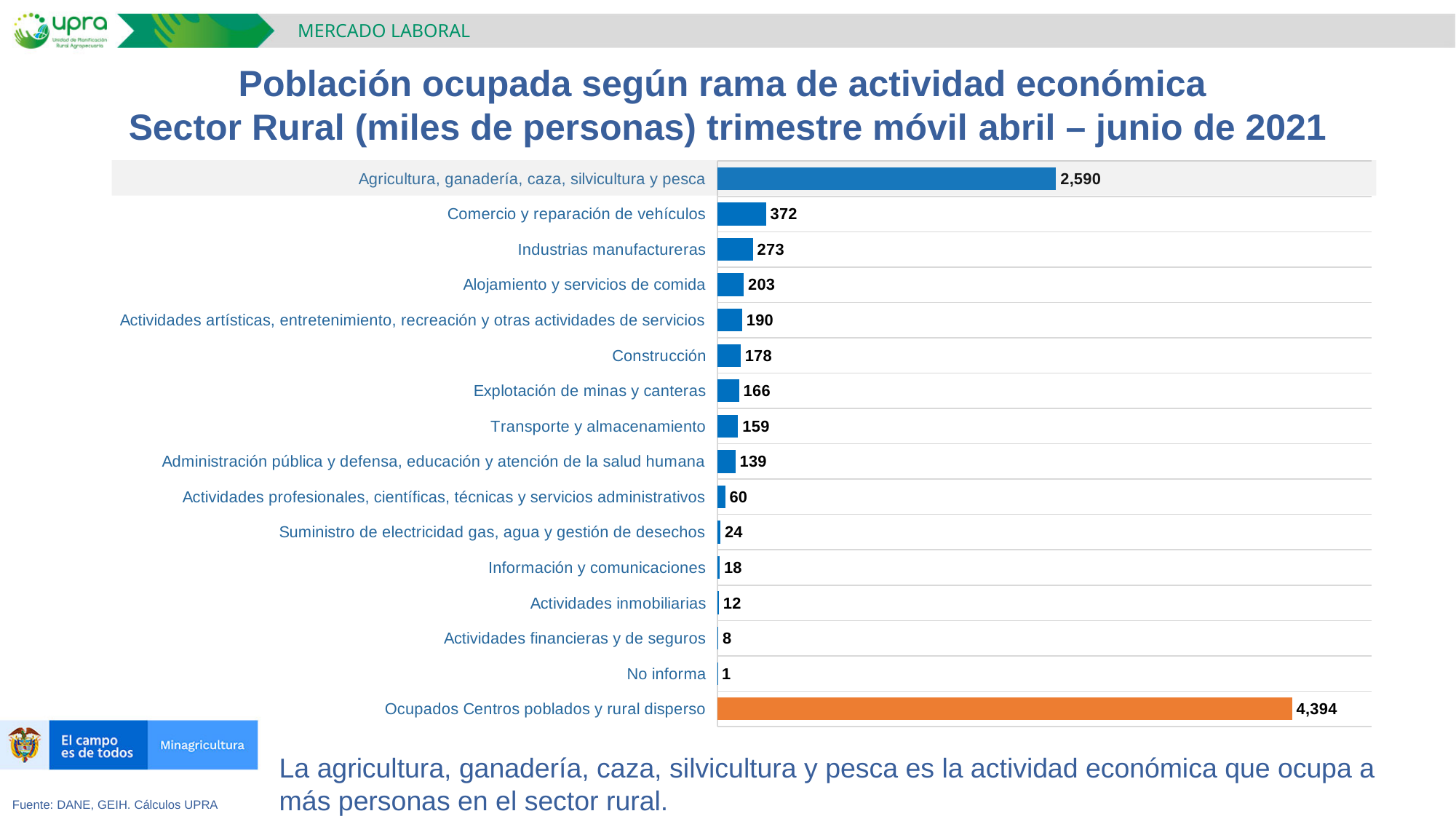
What is the difference between the values for Agricultura, ganadería, caza, silvicultura y pesca and Comercio y reparación de vehículos? 2,218 How many categories (bars) are shown in the chart? 16 Which category has the highest value in the chart? Ocupados Centros poblados y rural disperso Which category has the lowest value in the chart? No informa What type of chart is shown on the slide? Bar chart What is the value for Comercio y reparación de vehículos? 372 What is the difference between the values for Comercio y reparación de vehículos and Industrias manufactureras? 99 What colour is the bar for Ocupados Centros poblados y rural disperso? Orange What is the value for Transporte y almacenamiento? 159 Which is larger, the value for Construcción or the value for Explotación de minas y canteras? Construcción What is the value for Agricultura, ganadería, caza, silvicultura y pesca? 2,590 What is the value for Ocupados Centros poblados y rural disperso? 4,394